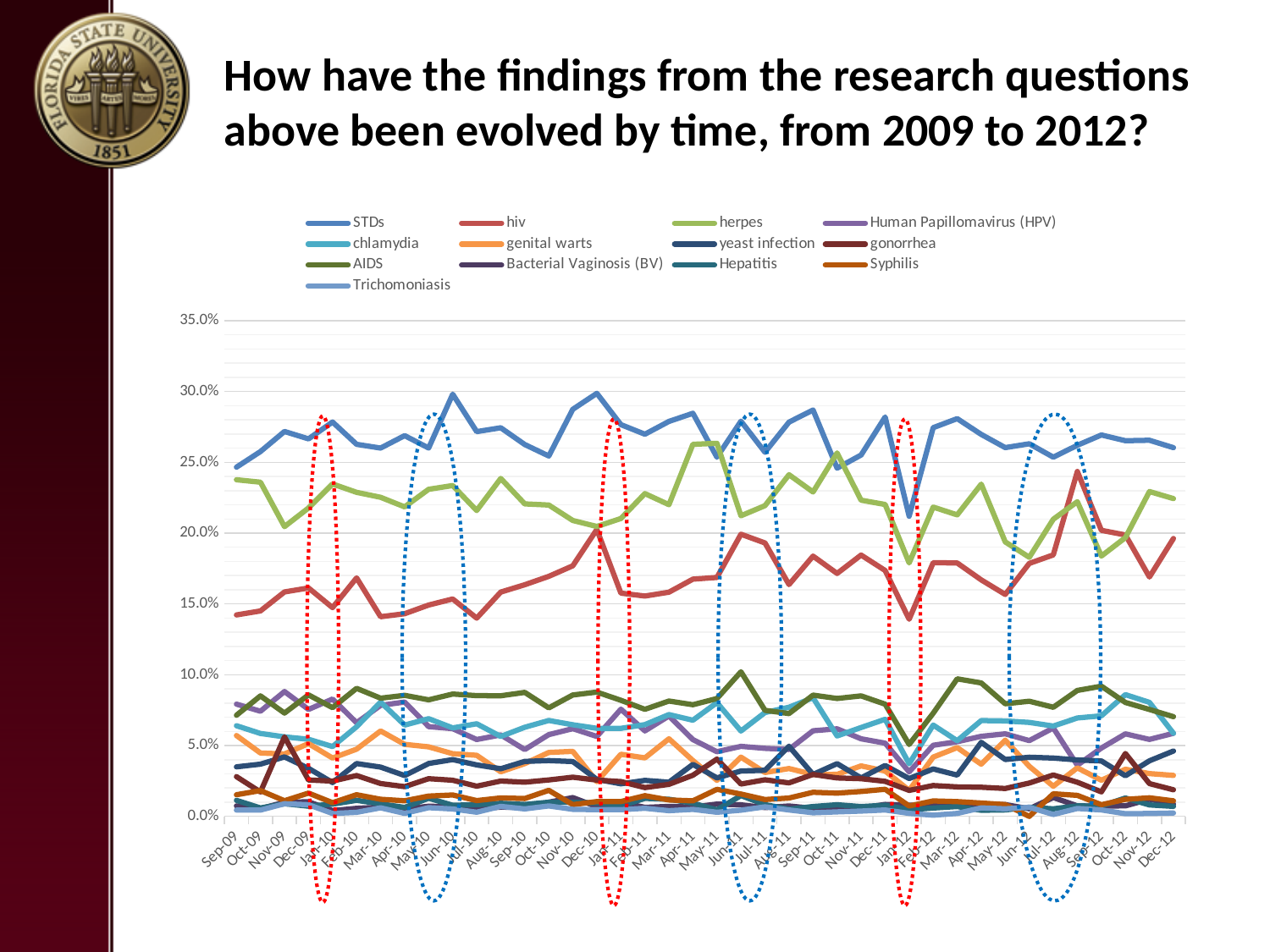
Does the hiv series generally rise or fall from Sep-09 to Dec-10? rise Is the value for herpes in Jan-12 greater or less than 20.0%? less What is the first month shown on the x axis? Sep-09 How many monthly points are plotted along the x axis, from Sep-09 to Dec-12? 40 Is the value for STDs in Jun-10 greater or less than 25.0%? greater In Jan-12, which is larger, the value for herpes or the value for hiv? herpes What kind of chart is shown on the slide? line chart Which series has the highest values across the whole period? STDs Is the value for STDs in Jan-12 greater or less than 25.0%? less In Sep-09, which is larger, the value for STDs or the value for herpes? STDs How many series does the legend list? 13